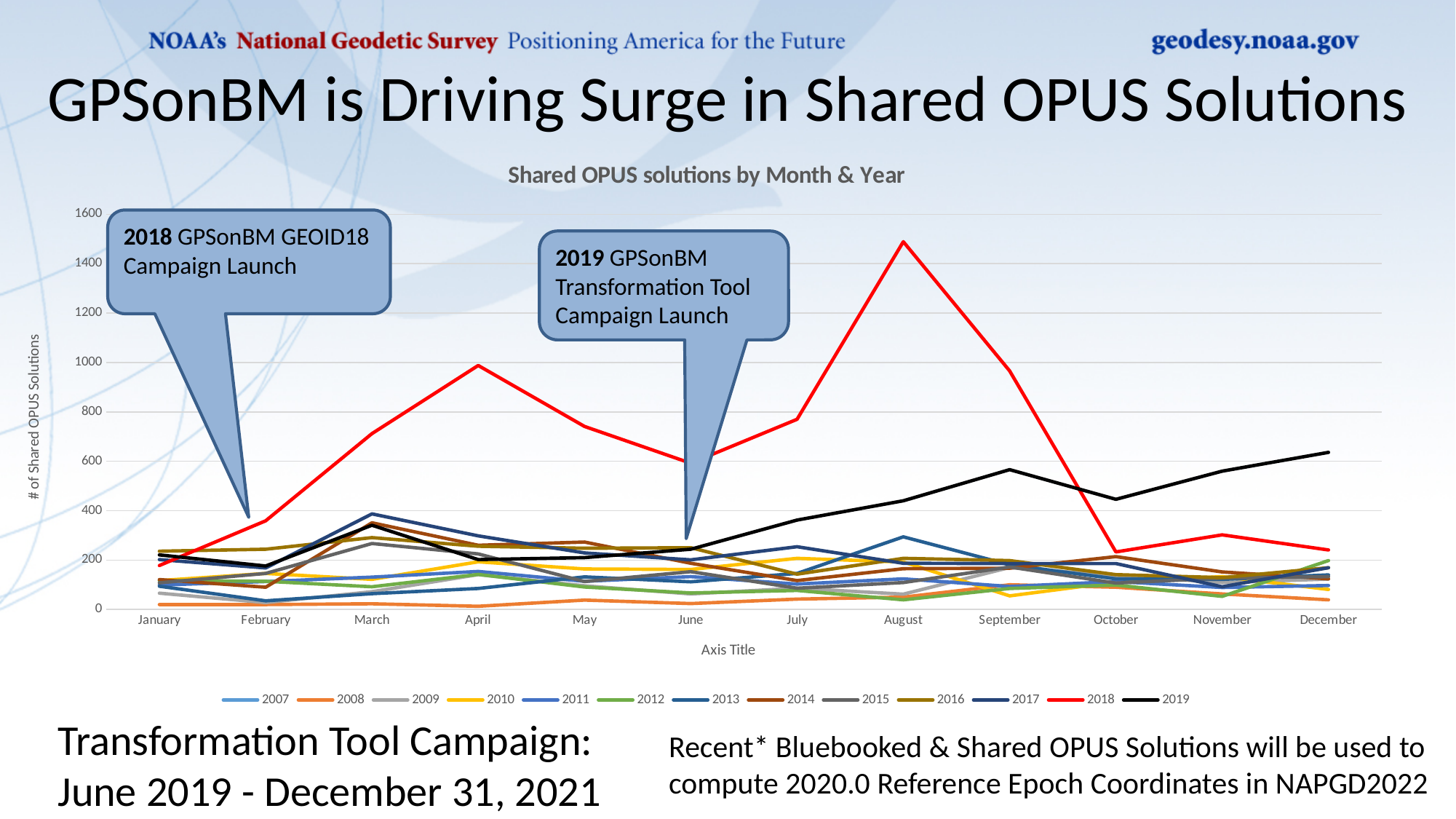
What kind of chart is shown on the slide? line chart Does the 2018 series rise or fall from August to October? fall In December, which series has the higher value, 2018 or 2019? 2019 In which month does the 2018 series reach its highest value? August How many months are shown along the x axis of the chart? 12 Is the value for 2018 in October greater or less than 400? less What is the label on the vertical axis of the chart? # of Shared OPUS Solutions What is the title of the chart? Shared OPUS solutions by Month & Year Is the value for 2018 in August greater or less than 1400? greater Is the value for 2018 in April greater or less than 800? greater Which series reaches the highest value anywhere on the chart? 2018 How many series does the chart legend list? 13